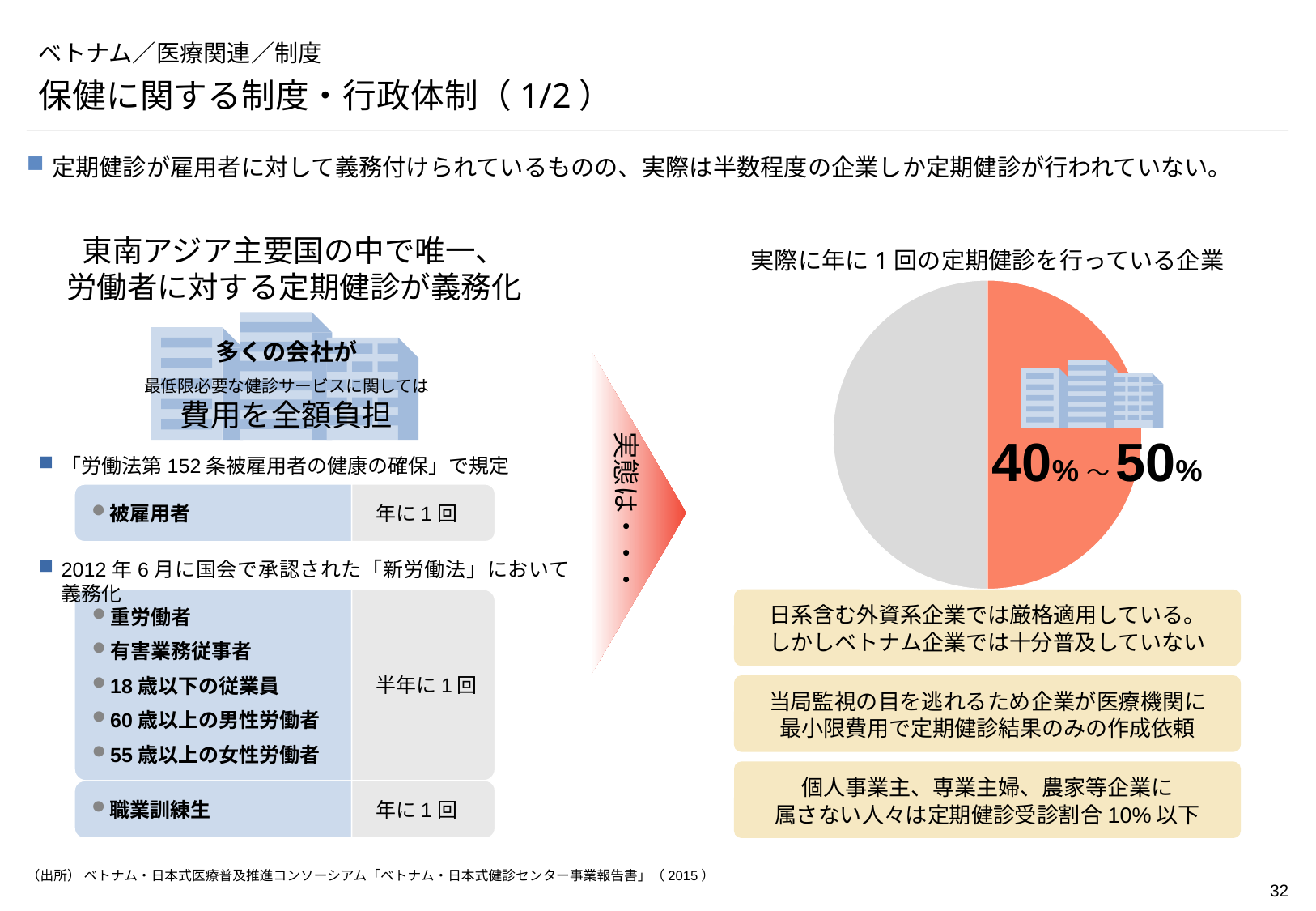
What kind of chart is shown on the right side of the slide? pie chart What value is printed on the red slice of the pie chart? 40%～50% What is the title of the pie chart on the right side of the slide? 実際に年に1回の定期健診を行っている企業 According to the pie chart, what share of companies actually conduct an annual health check-up? 40%～50% What colour is the slice of the pie chart that carries the 40%～50% label? red How many slices does the pie chart have? 2